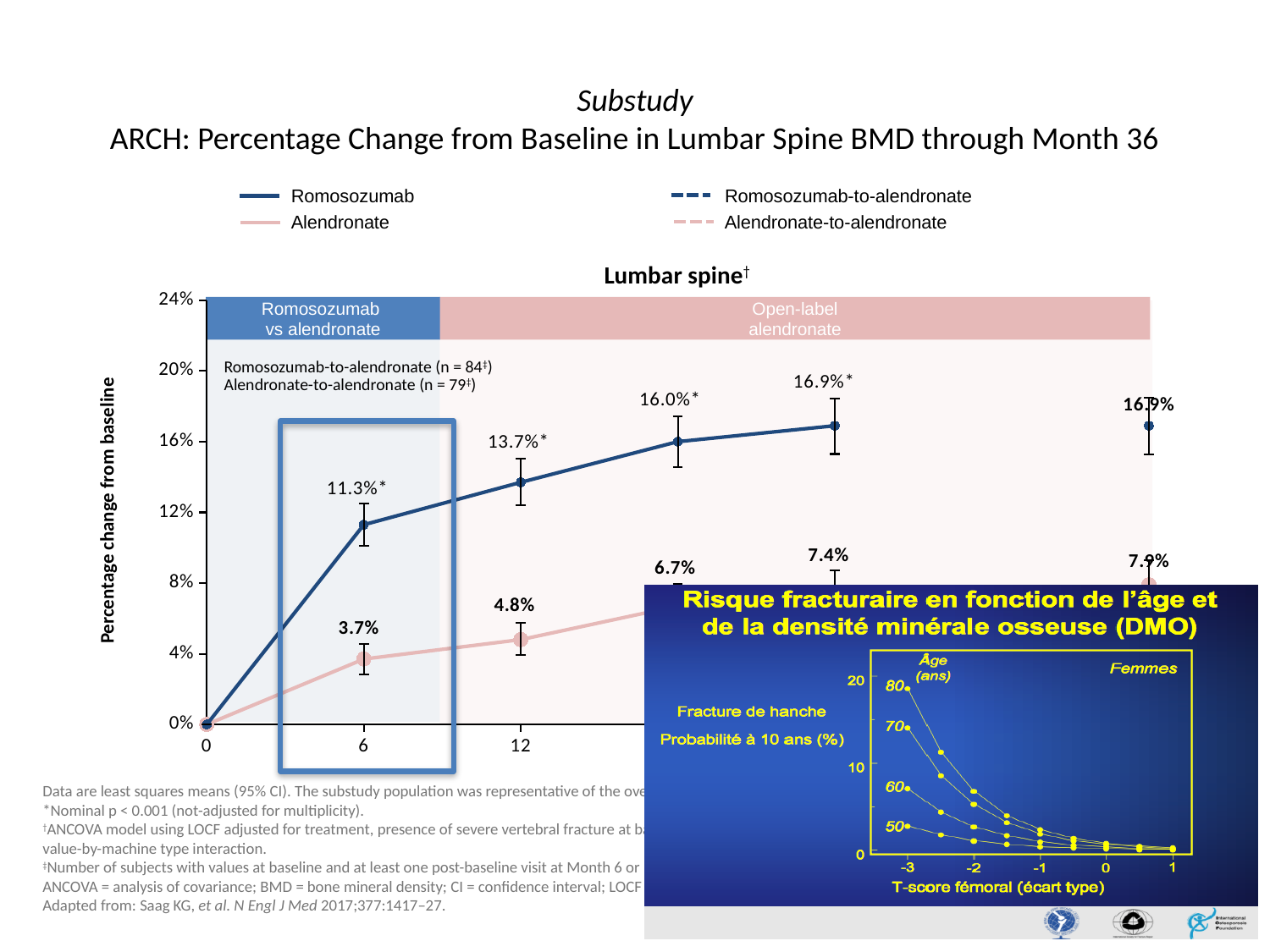
How many series does the legend of the lumbar spine chart list? 4 What is the y-axis title of the lumbar spine chart? Percentage change from baseline In the lumbar spine chart, what is the difference between the Romosozumab and Alendronate values at month 12? 8.9 percentage points In the lumbar spine chart, what is the percentage change from baseline for Alendronate at month 6? 3.7% In the lumbar spine chart, what is the percentage change from baseline for Alendronate at month 12? 4.8% In the lumbar spine chart, what is the percentage change from baseline for Romosozumab at month 6? 11.3% What kind of chart is the lumbar spine BMD chart? Line chart In the lumbar spine chart, what is the highest labelled value on the Romosozumab line? 16.9% In the lumbar spine chart, which treatment has the larger percentage change from baseline at month 6, Romosozumab or Alendronate? Romosozumab In the lumbar spine chart, does the Romosozumab line rise or fall from month 0 to month 12? Rise In the lumbar spine chart, what is the percentage change from baseline for Romosozumab at month 12? 13.7% In the lumbar spine chart, what is the difference between the Romosozumab and Alendronate values at month 6? 7.6 percentage points